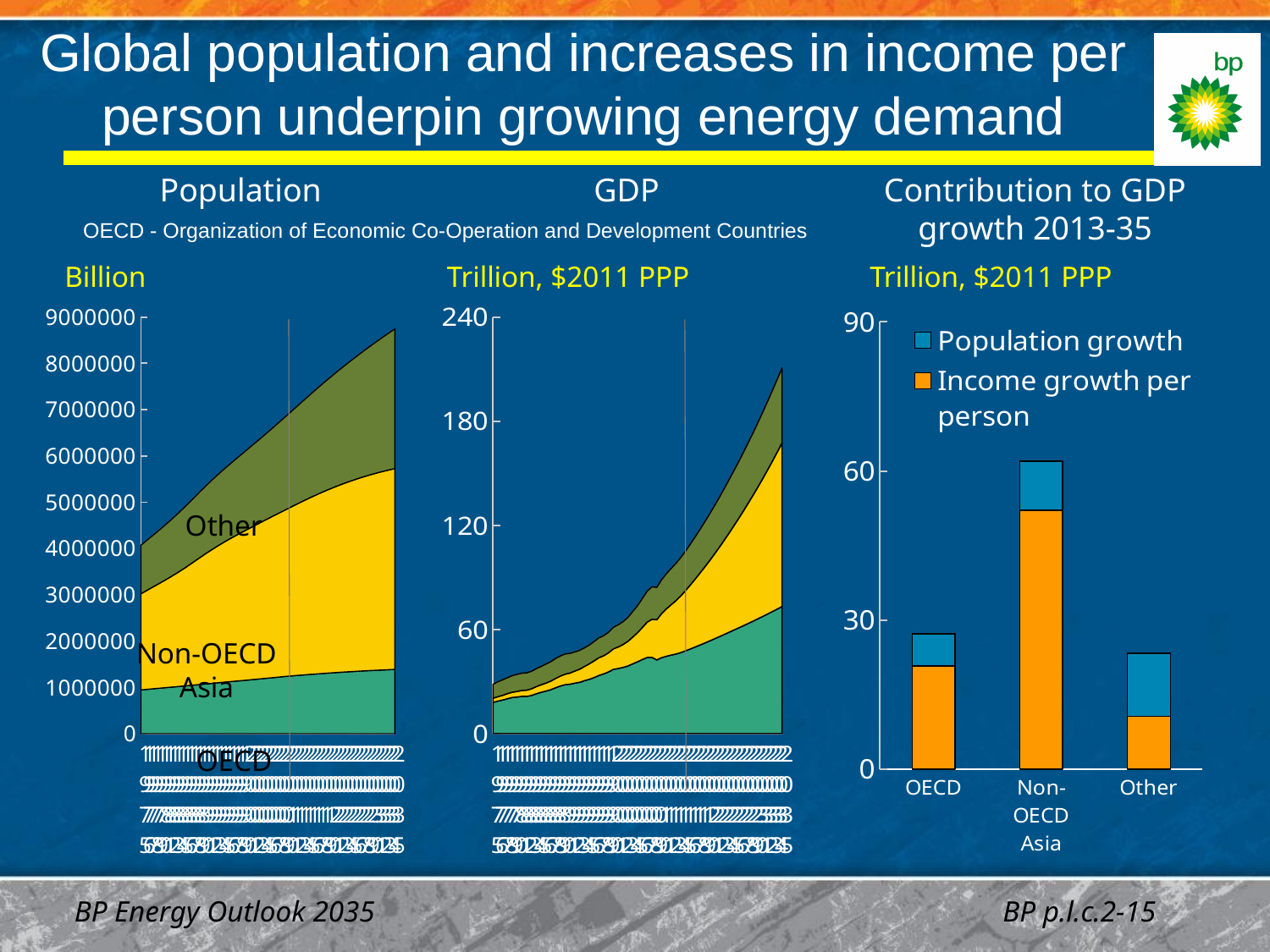
What kind of chart is the 'Contribution to GDP growth 2013-35' chart? bar chart In the 'Population' chart, is the total population at the right end of the chart greater or less than 8000000? greater In the 'GDP' chart, is the total value at the right end of the chart greater or less than 180? greater What unit label is shown above the 'GDP' chart? Trillion, $2011 PPP In the 'Contribution to GDP growth 2013-35' chart, is the total bar for OECD greater or less than 30? less In the 'Contribution to GDP growth 2013-35' chart, which category has the tallest bar? Non-OECD Asia How many series does the legend of the 'Contribution to GDP growth 2013-35' chart list? 2 In the 'Contribution to GDP growth 2013-35' chart, which series is shown in orange? Income growth per person In the 'GDP' chart, does the total GDP rise or fall over time along the x axis? rise How many categories are shown on the x axis of the 'Contribution to GDP growth 2013-35' chart? 3